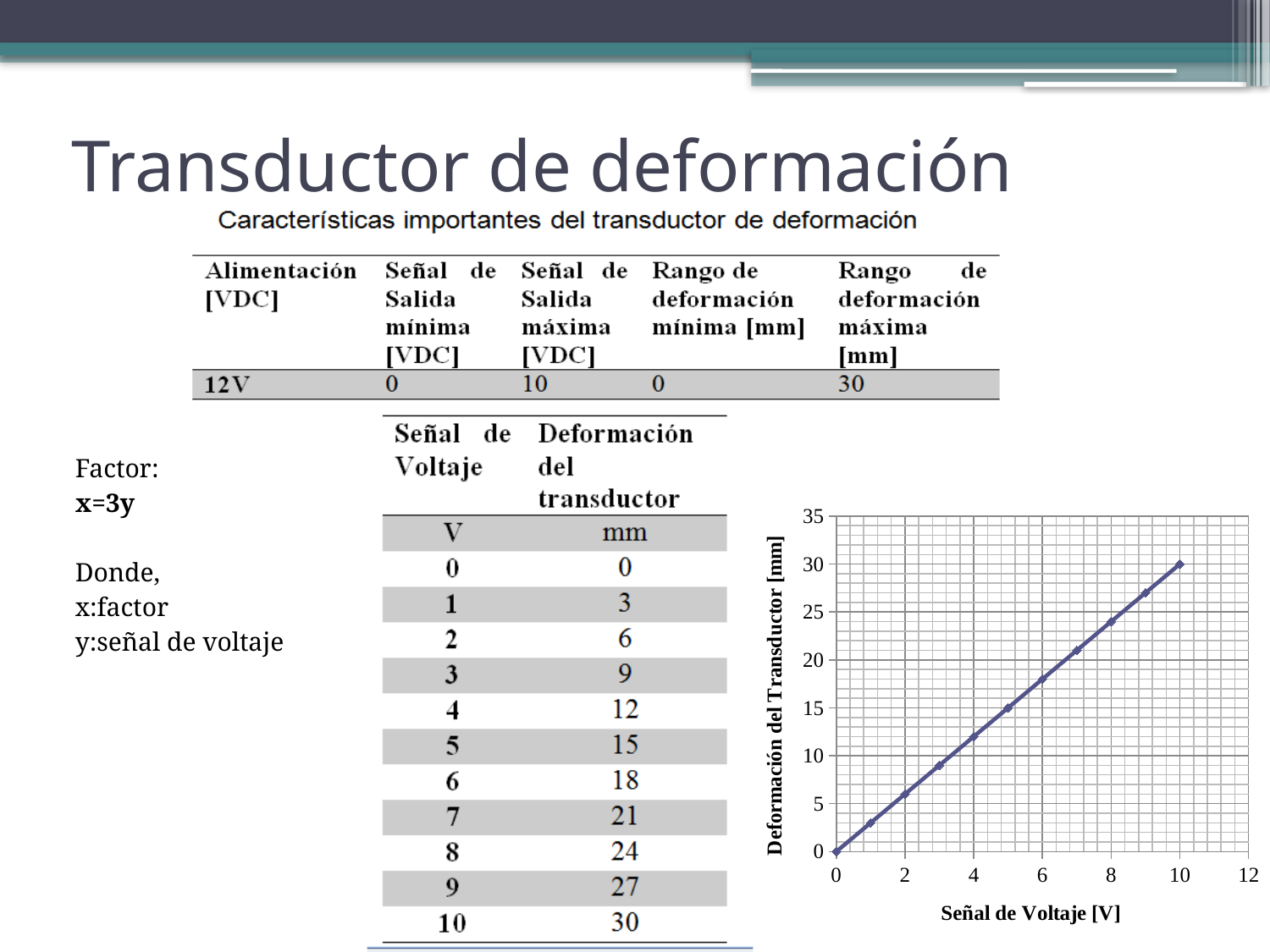
What is the title of the x axis of the chart? Señal de Voltaje [V] What is the title of the y axis of the chart? Deformación del Transductor [mm] At which voltage signal is the deformation of the transducer lowest? 0 How many data points are plotted on the chart? 11 Do the values in the chart rise or fall as the voltage signal increases along the x axis? rise At which voltage signal is the deformation of the transducer highest? 10 What kind of chart is shown on the slide? line chart Which is larger, the deformation at 3 V or the deformation at 7 V? 7 V What is the deformation of the transducer at a voltage signal of 5 V? 15 What is the deformation of the transducer at a voltage signal of 0 V? 0 Is the deformation at a voltage signal of 8 V greater or less than 20? greater What is the deformation of the transducer at a voltage signal of 10 V? 30